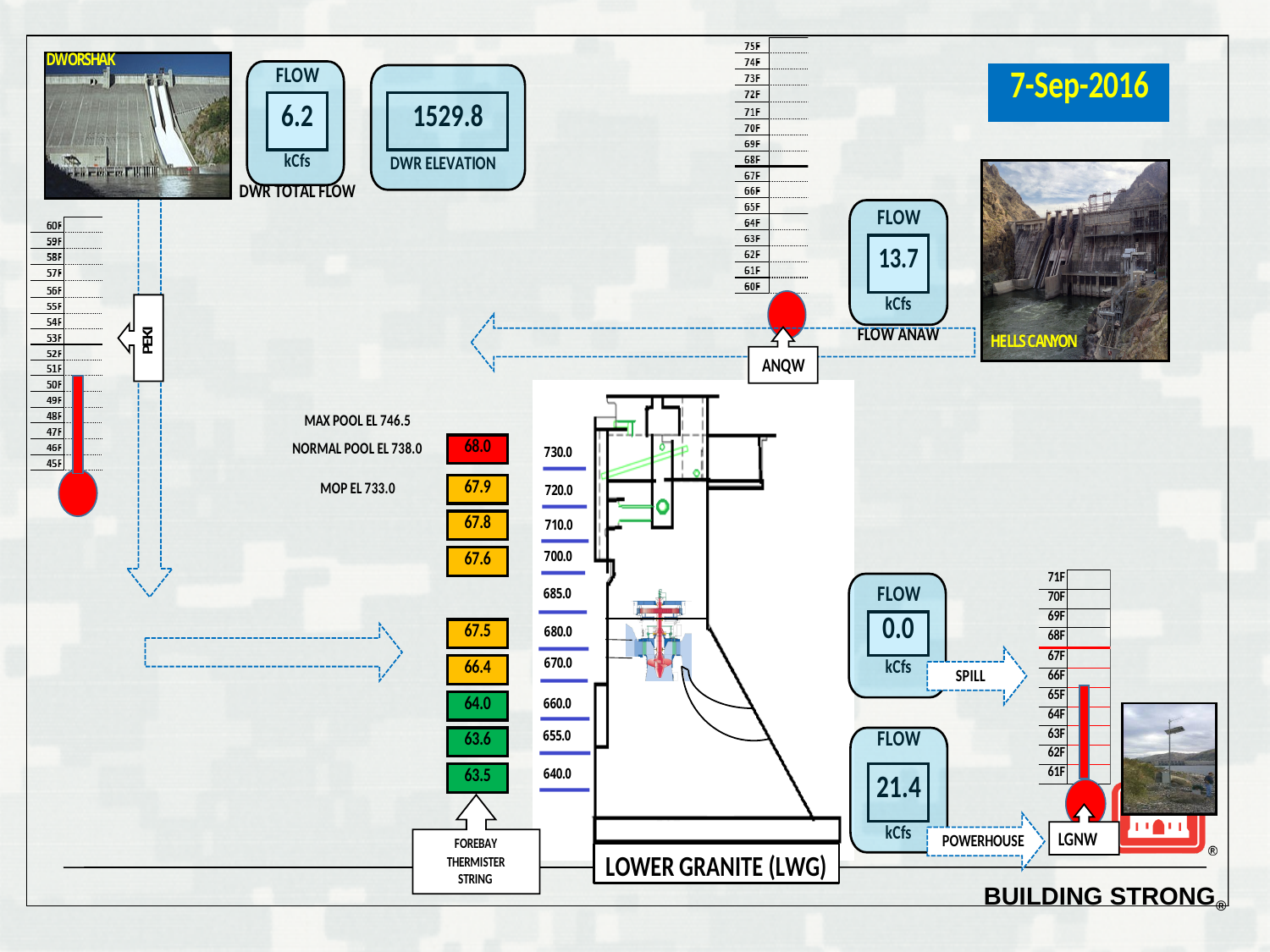
Do the forebay thermistor string values increase or decrease going from the top of the column to the bottom? Decrease What DWR elevation value is displayed on the slide? 1529.8 What is the highest temperature value shown in the forebay thermistor string column? 68.0 What is the Flow ANAW value shown near the Hells Canyon photo? 13.7 kCfs What date is shown in the yellow box at the top right of the slide? 7-Sep-2016 Which is larger, the powerhouse flow or the Flow ANAW value? Powerhouse flow What is the spill flow value shown for Lower Granite? 0.0 kCfs How many temperature values are listed in the forebay thermistor string column? 9 What is the DWR total flow value shown in the flow box next to the Dworshak photo? 6.2 kCfs What is the lowest temperature value shown in the forebay thermistor string column? 63.5 What is the difference between the powerhouse flow (21.4 kCfs) and the Flow ANAW value (13.7 kCfs)? 7.7 kCfs What is the powerhouse flow value shown for Lower Granite? 21.4 kCfs